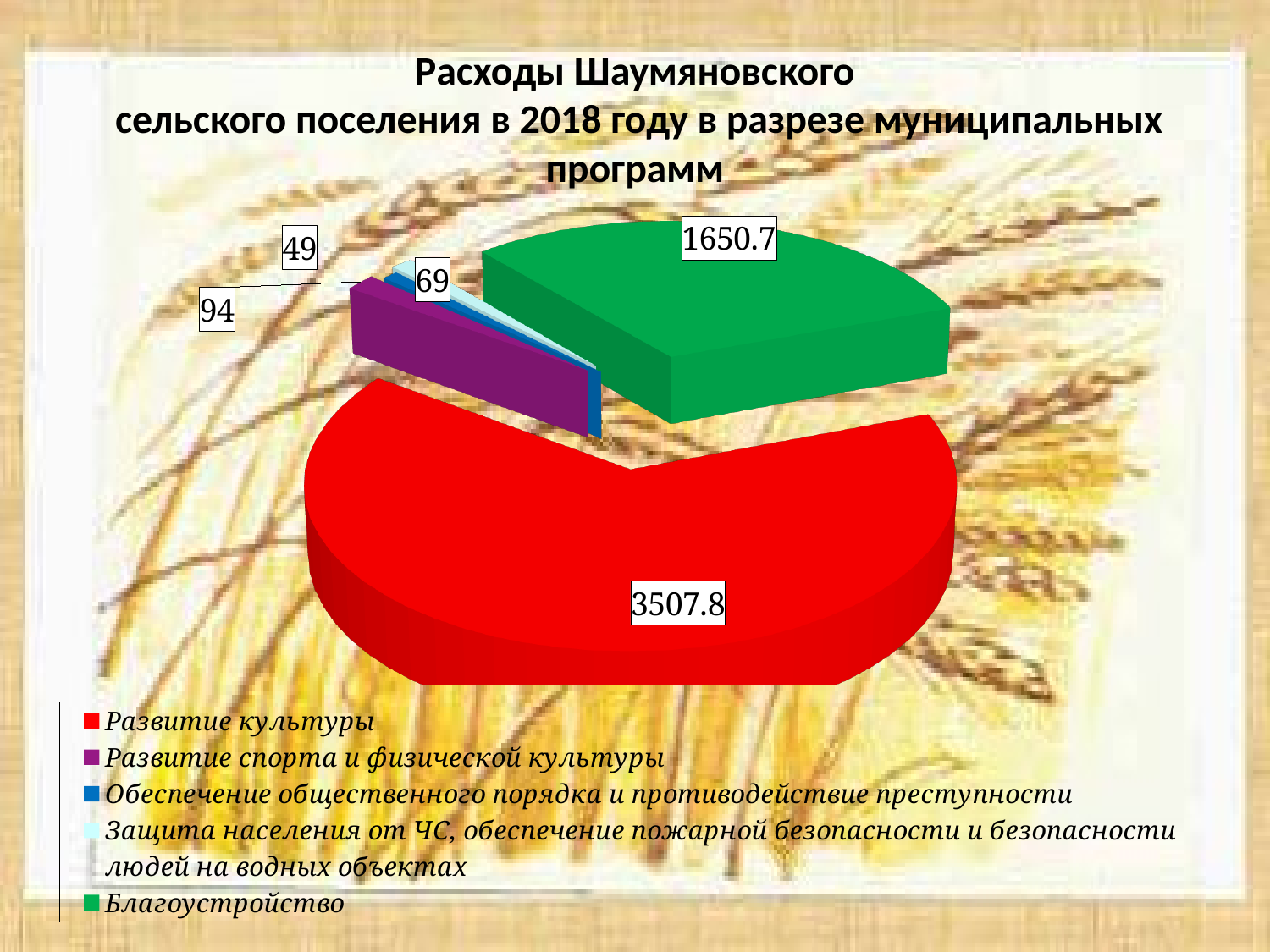
What is the value for Развитие культуры? 3507.8 How many entries does the legend list? 5 What is the title of the chart? Расходы Шаумяновского сельского поселения в 2018 году в разрезе муниципальных программ What is the value for Развитие спорта и физической культуры? 94 What is the difference between the values for Развитие культуры and Благоустройство? 1857.1 What is the value for Благоустройство? 1650.7 Which category has the largest slice of the pie? Развитие культуры What kind of chart is shown on the slide? pie chart What colour is the slice for Благоустройство? green Which is larger, Развитие культуры or Благоустройство? Развитие культуры What is the difference between the values for Благоустройство and Развитие спорта и физической культуры? 1556.7 How many slices does the pie chart have? 5